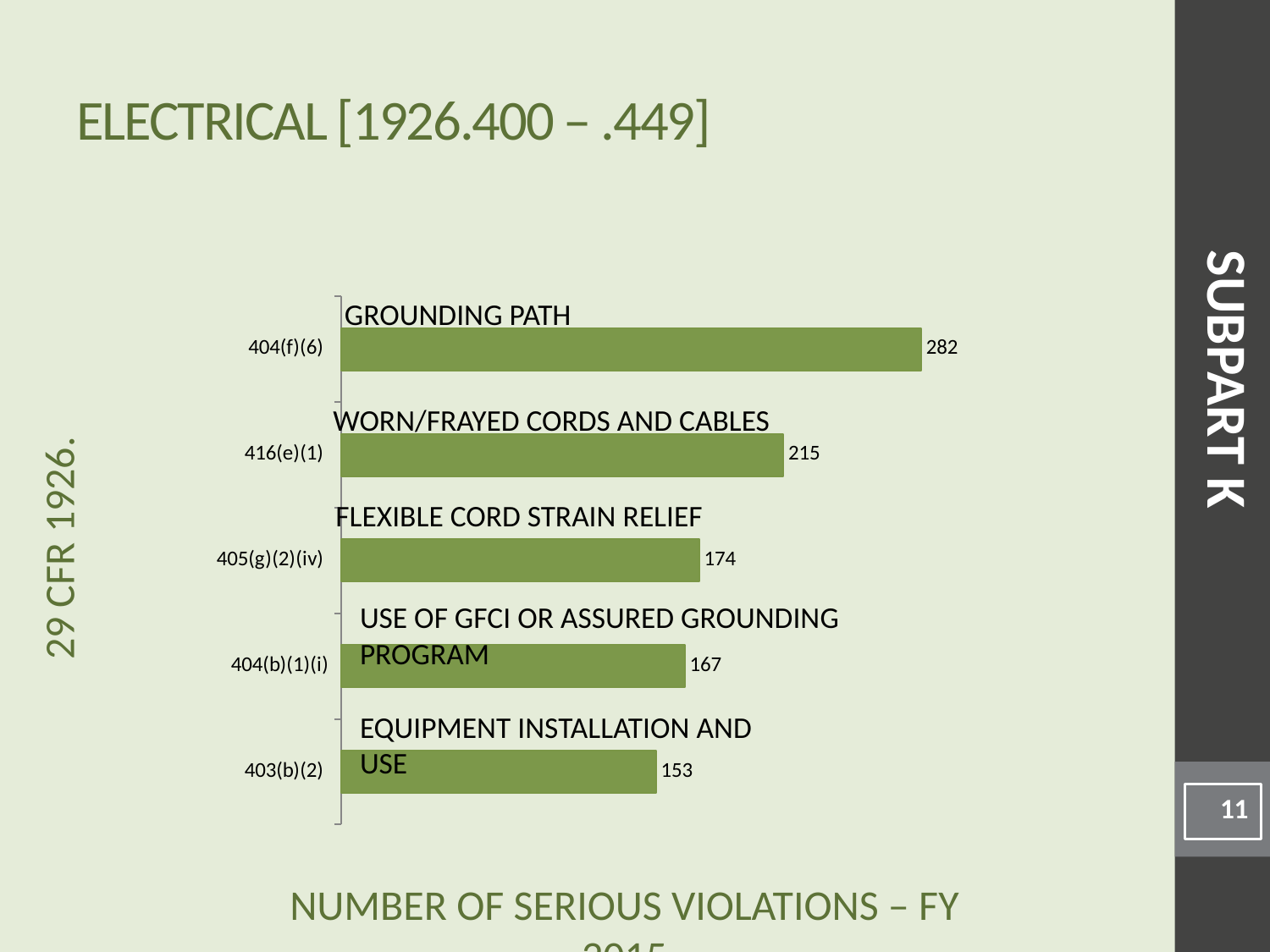
What is the number of serious violations for 416(e)(1) (Worn/Frayed Cords and Cables)? 215 What is the title of the slide containing the chart? ELECTRICAL [1926.400 – .449] What is the difference in serious violations between 404(f)(6) and 416(e)(1)? 67 What is the difference in serious violations between 404(b)(1)(i) and 403(b)(2)? 14 How many standards are shown in the chart? 5 What is the number of serious violations for 405(g)(2)(iv) (Flexible Cord Strain Relief)? 174 Which standard has the lowest number of serious violations? 403(b)(2) What is the number of serious violations for 403(b)(2) (Equipment Installation and Use)? 153 Which has more serious violations, 405(g)(2)(iv) or 404(b)(1)(i)? 405(g)(2)(iv) What type of chart is shown on the slide? Bar chart What is the number of serious violations for 404(f)(6) (Grounding Path)? 282 Which standard has the highest number of serious violations? 404(f)(6)